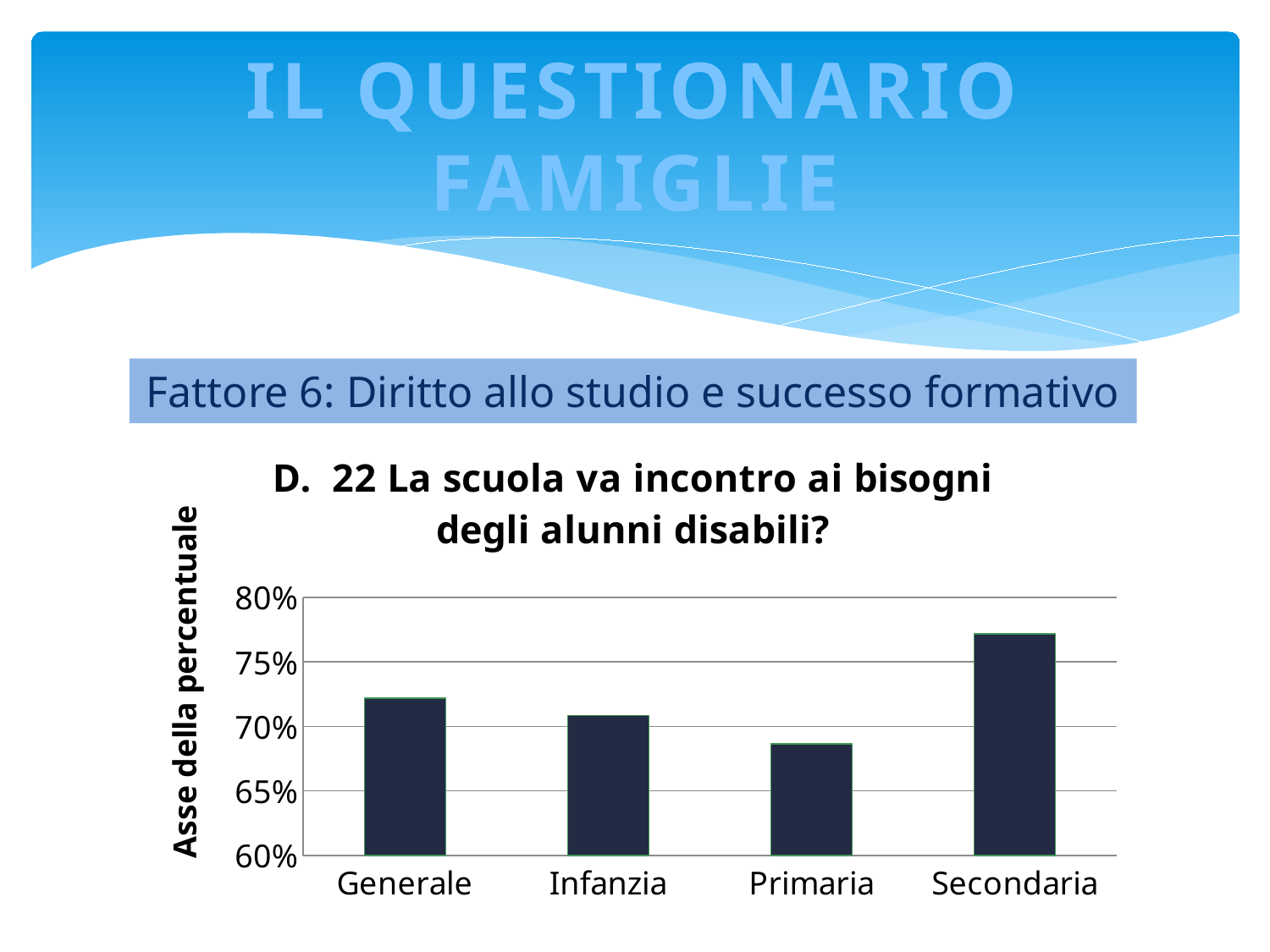
What is the label of the vertical axis of the chart? Asse della percentuale What is the title of the chart? D. 22 La scuola va incontro ai bisogni degli alunni disabili? Is the value for Secondaria greater or less than 75%? greater Which is larger, the value for Secondaria or the value for Primaria? Secondaria Which category has the highest value in the chart? Secondaria How many categories are shown on the x axis of the chart? 4 Which category has the lowest value in the chart? Primaria Which is larger, the value for Generale or the value for Primaria? Generale What kind of chart is shown on the slide? bar chart Is the value for Infanzia greater or less than 75%? less Is the value for Primaria greater or less than 70%? less